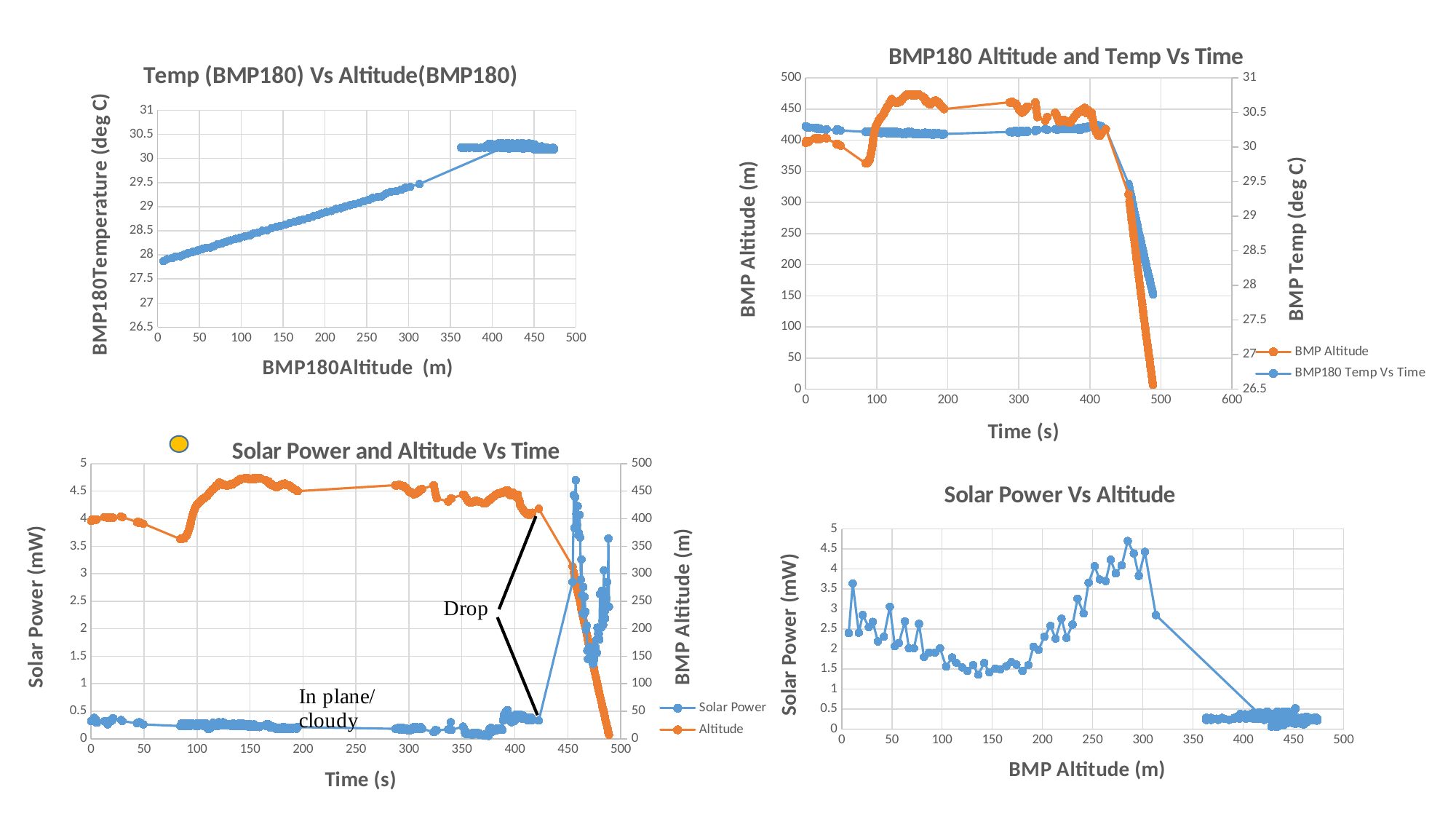
What is the x-axis label of "Solar Power Vs Altitude"? BMP Altitude (m) How many series does the legend of "BMP180 Altitude and Temp Vs Time" list? 2 In "Temp (BMP180) Vs Altitude(BMP180)", is the temperature at an altitude of 400 m greater or less than 30 deg C? greater What are the legend entries of "Solar Power and Altitude Vs Time"? Solar Power, Altitude In "Temp (BMP180) Vs Altitude(BMP180)", does the temperature rise or fall as altitude increases from 0 m to 300 m? rise In "Solar Power Vs Altitude", is the solar power at an altitude of 450 m greater or less than 1 mW? less In "Solar Power and Altitude Vs Time", is the Solar Power at 100 s greater or less than 1 mW? less What kind of chart is "Solar Power and Altitude Vs Time"? line chart In "Solar Power Vs Altitude", does solar power rise or fall as altitude increases from 150 m to 300 m? rise How many series does the legend of "Solar Power and Altitude Vs Time" list? 2